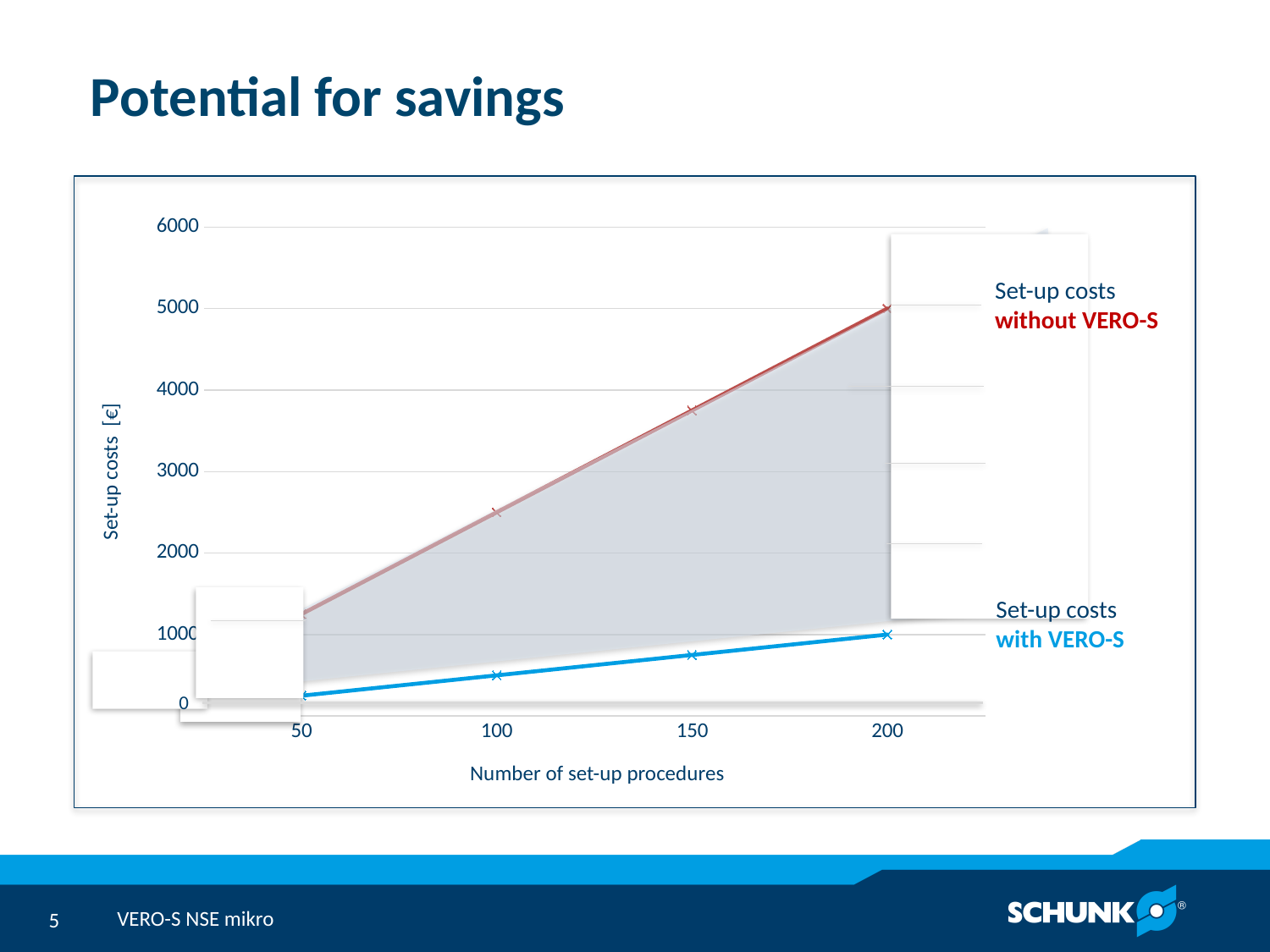
What is the difference between set-up costs without VERO-S and with VERO-S at 200 set-up procedures? 4000 Are the set-up costs without VERO-S at 150 set-up procedures greater or less than 4000? less Do the set-up costs without VERO-S rise or fall as the number of set-up procedures increases? rise How many set-up procedure values are marked on the x axis? 4 What kind of chart is shown on the slide? line chart What is the label of the x axis? Number of set-up procedures What are the set-up costs without VERO-S at 200 set-up procedures? 5000 Are the set-up costs with VERO-S at 150 set-up procedures greater or less than 1000? less What are the set-up costs with VERO-S at 200 set-up procedures? 1000 How many series does the chart show? 2 Are the set-up costs without VERO-S at 100 set-up procedures greater or less than 2000? greater At 150 set-up procedures, which series has the higher set-up costs: with VERO-S or without VERO-S? without VERO-S